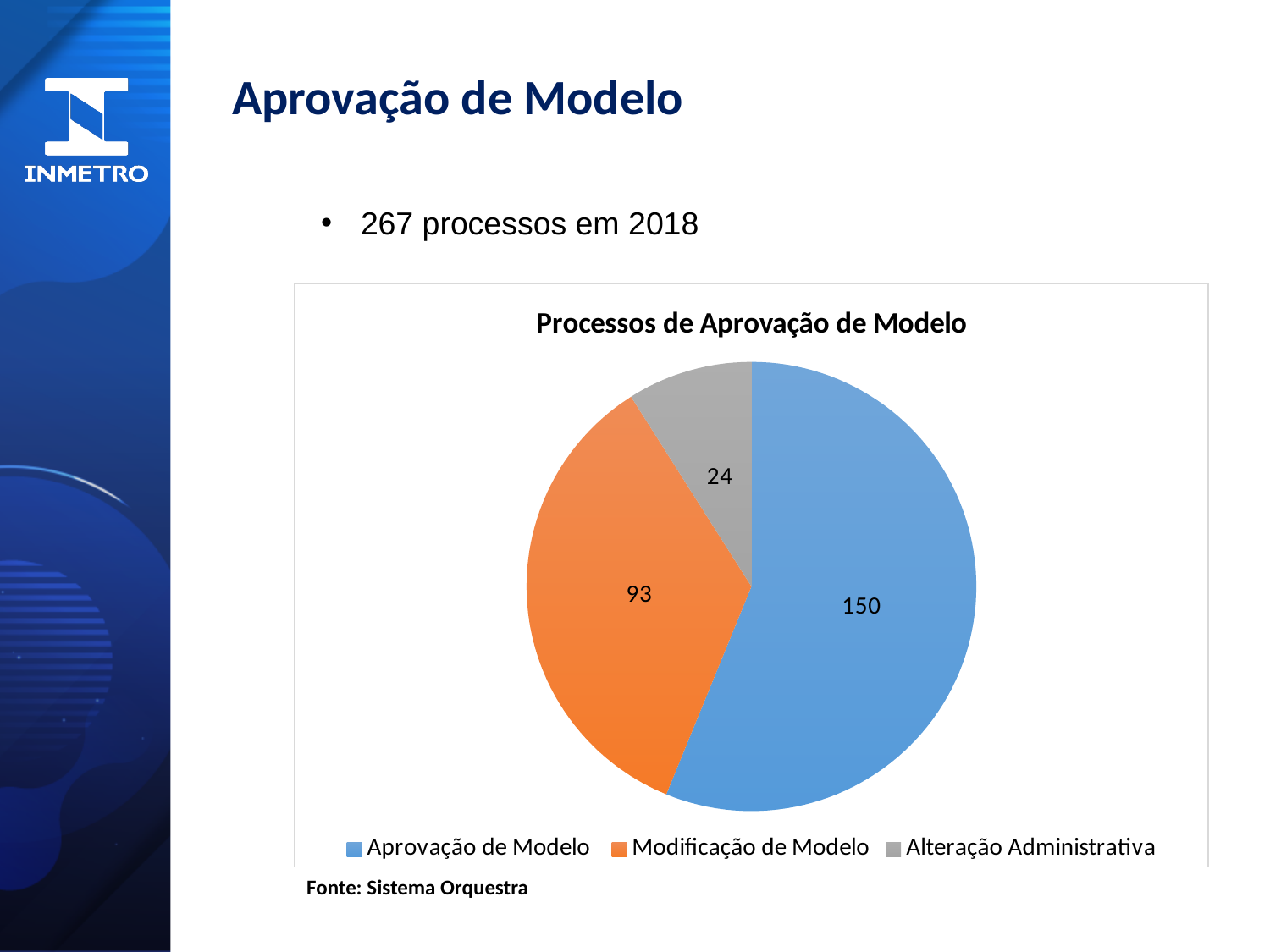
What is the difference between the values for Aprovação de Modelo and Modificação de Modelo? 57 What is the value for Alteração Administrativa? 24 What is the difference between the values for Modificação de Modelo and Alteração Administrativa? 69 What is the value for Aprovação de Modelo? 150 What is the title of the chart? Processos de Aprovação de Modelo Which is larger, Modificação de Modelo or Alteração Administrativa? Modificação de Modelo What is the value for Modificação de Modelo? 93 Which category has the smallest slice? Alteração Administrativa Which category has the largest slice? Aprovação de Modelo What is the total of all slices in the pie chart? 267 What type of chart is shown on the slide? pie chart How many slices does the pie chart have? 3